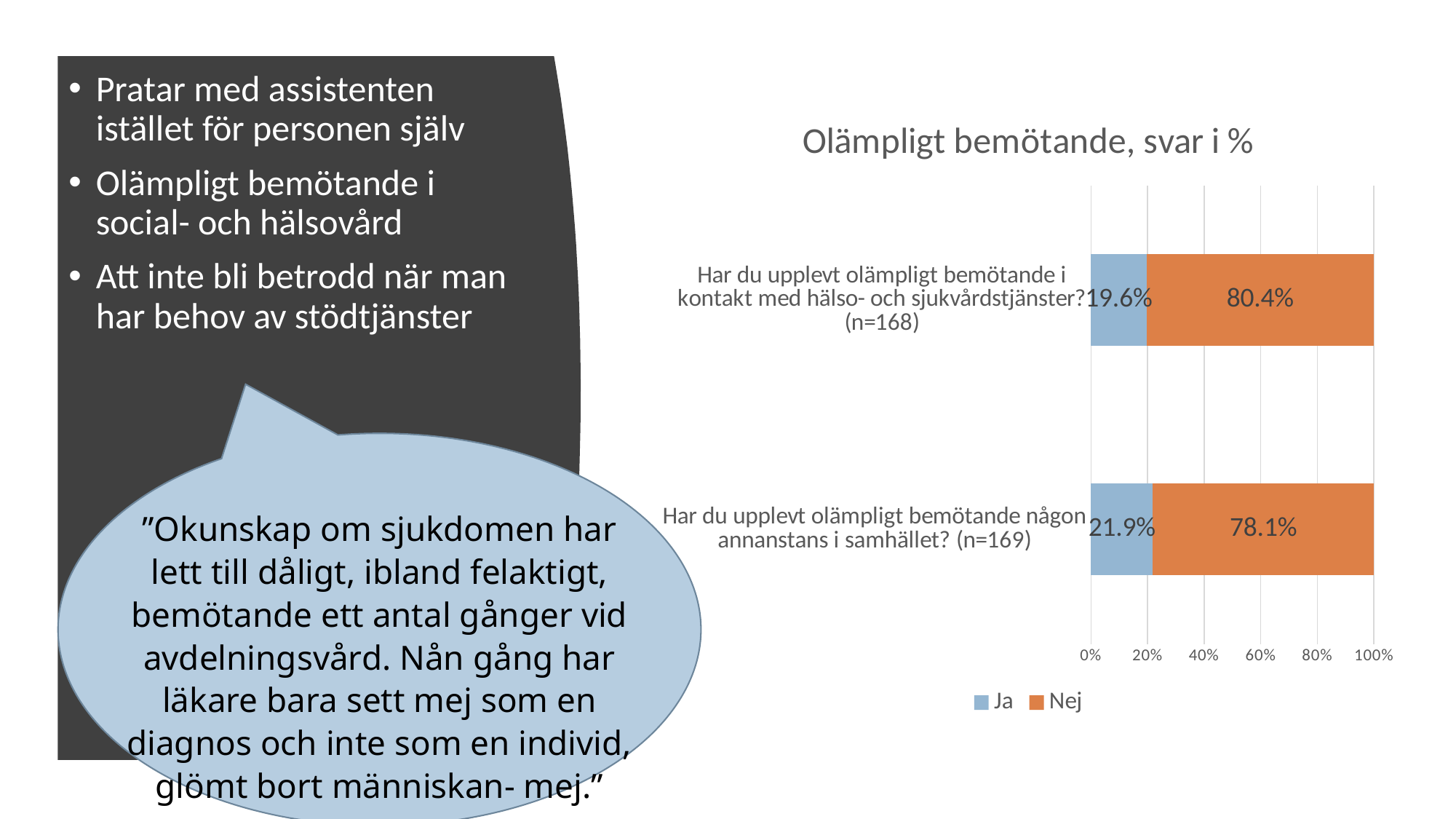
What is the 'Nej' value for 'Har du upplevt olämpligt bemötande i kontakt med hälso- och sjukvårdstjänster? (n=168)'? 80.4% How many series does the chart legend list? 2 Which question has the higher 'Ja' share? Har du upplevt olämpligt bemötande någon annanstans i samhället? (n=169) What is the 'Ja' value for 'Har du upplevt olämpligt bemötande någon annanstans i samhället? (n=169)'? 21.9% What is the 'Ja' value for 'Har du upplevt olämpligt bemötande i kontakt med hälso- och sjukvårdstjänster? (n=168)'? 19.6% What is the title of the chart? Olämpligt bemötande, svar i % What are the series names in the chart legend? Ja, Nej Is the 'Ja' value for 'Har du upplevt olämpligt bemötande i kontakt med hälso- och sjukvårdstjänster? (n=168)' greater or less than 20%? less How many questions (categories) are plotted in the chart? 2 What kind of chart is shown on the slide? Stacked bar chart What is the difference between the 'Nej' values for the two questions? 2.3% What is the 'Nej' value for 'Har du upplevt olämpligt bemötande någon annanstans i samhället? (n=169)'? 78.1%